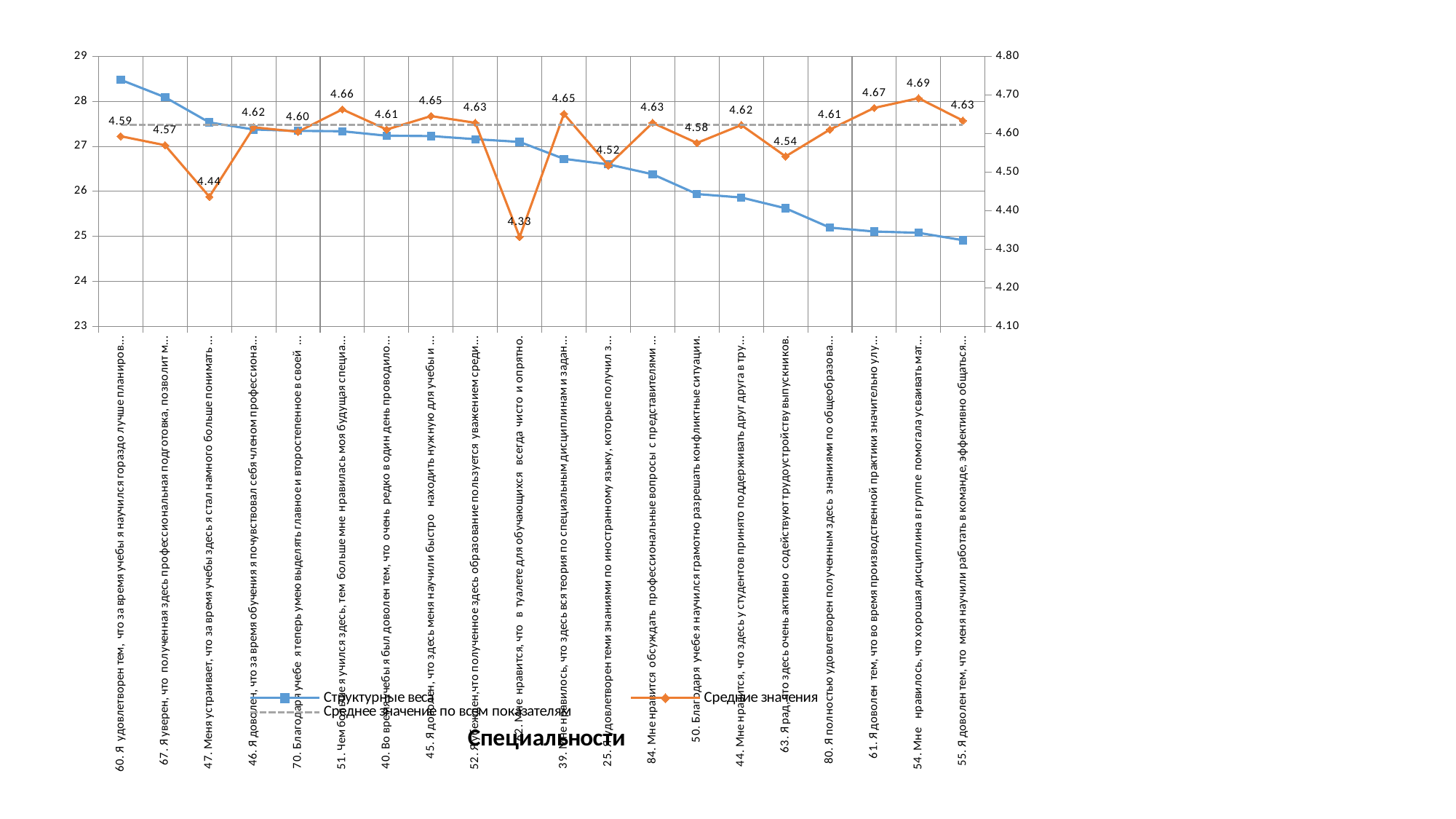
How many categories are plotted along the x axis? 20 Which is larger: the 'Средние значения' value for category '51' (4.66) or for category '25' (4.52)? 51 (4.66) Which category has the lowest 'Средние значения' value? 62. Мне нравится, что в туалете для обучающихся всегда чисто и опрятно. Which category has the highest 'Средние значения' value? 54. Мне нравилось, что хорошая дисциплина в группе... Is the 'Структурные веса' value for the first category ('60. Я удовлетворен тем...') greater or less than 28? greater Do the 'Структурные веса' values generally rise or fall from left to right along the x axis? fall How many series does the legend list? 3 What is the value of 'Средние значения' for the category beginning '47. Меня устраивает...'? 4.44 What kind of chart is shown on the slide? line chart What is the difference between the highest and lowest 'Средние значения' values (4.69 and 4.33)? 0.36 What is the value of 'Средние значения' for the category beginning '54. Мне нравилось, что хорошая дисциплина...'? 4.69